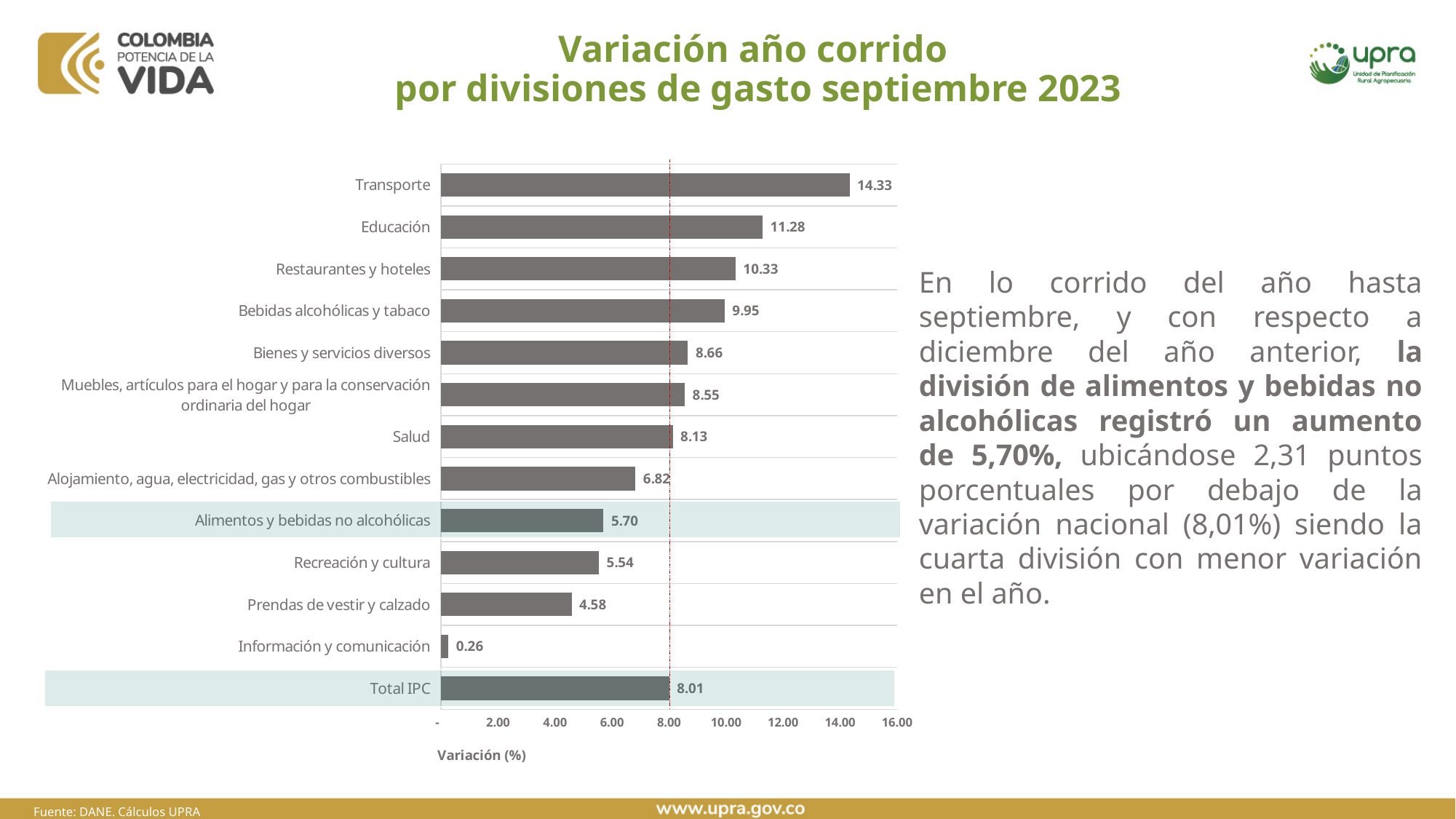
What is the value for Alimentos y bebidas no alcohólicas? 5.70 What kind of chart is shown on the slide? Bar chart What is the difference between the values for Educación and Restaurantes y hoteles? 0.95 What is the label of the horizontal axis? Variación (%) Which category has the lowest value? Información y comunicación What is the value for Transporte? 14.33 What is the value for Total IPC? 8.01 Is the value for Bebidas alcohólicas y tabaco greater or less than 8.00? greater Which category has the highest value? Transporte Which is larger, the value for Salud or the value for Alojamiento, agua, electricidad, gas y otros combustibles? Salud How many categories are shown in the chart? 13 What is the value for Prendas de vestir y calzado? 4.58